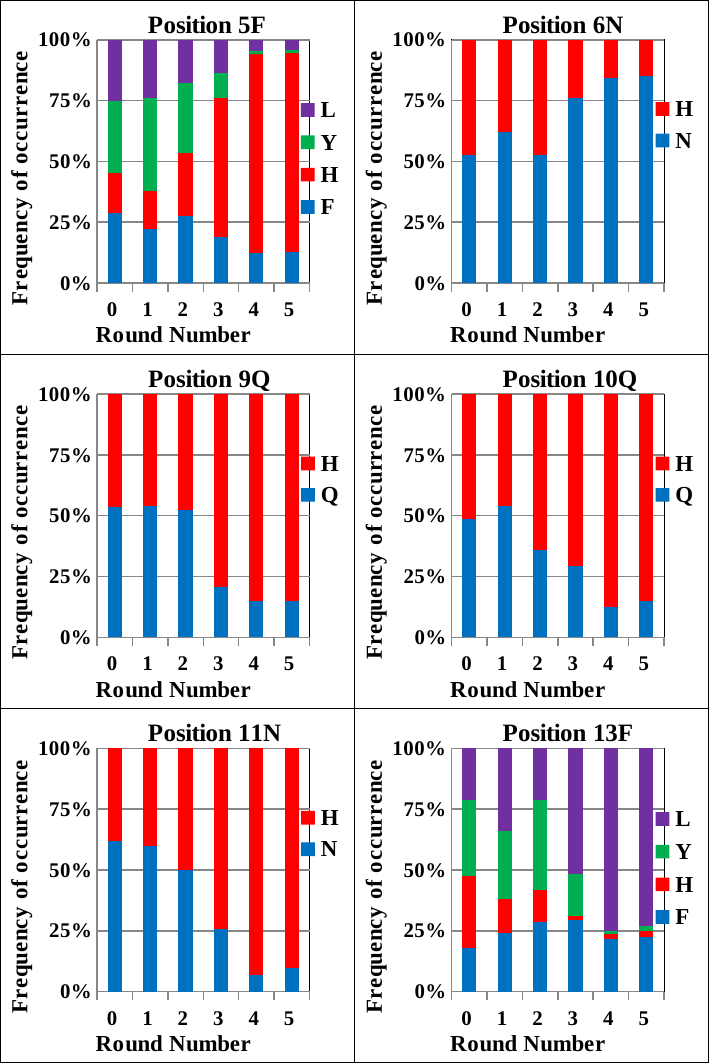
In the Position 6N chart, is the share of N at round 4 greater or less than 75%? greater What kind of chart is used for Position 6N? Stacked bar chart In the Position 11N chart, is the share of N at round 4 greater or less than 25%? less In the Position 9Q chart, how many round numbers are shown on the x axis? 6 In the Position 5F chart, how many series does the legend list? 4 In the Position 10Q chart, is the share of Q at round 0 greater or less than 25%? greater In the Position 10Q chart, which round has the highest share of Q? 1 What is the x-axis title on the Position 11N chart? Round Number In the Position 6N chart, how many series does the legend list? 2 In the Position 9Q chart, does the share of Q generally rise or fall from round 0 to round 5? fall In the Position 6N chart, does the share of N generally rise or fall from round 0 to round 5? rise